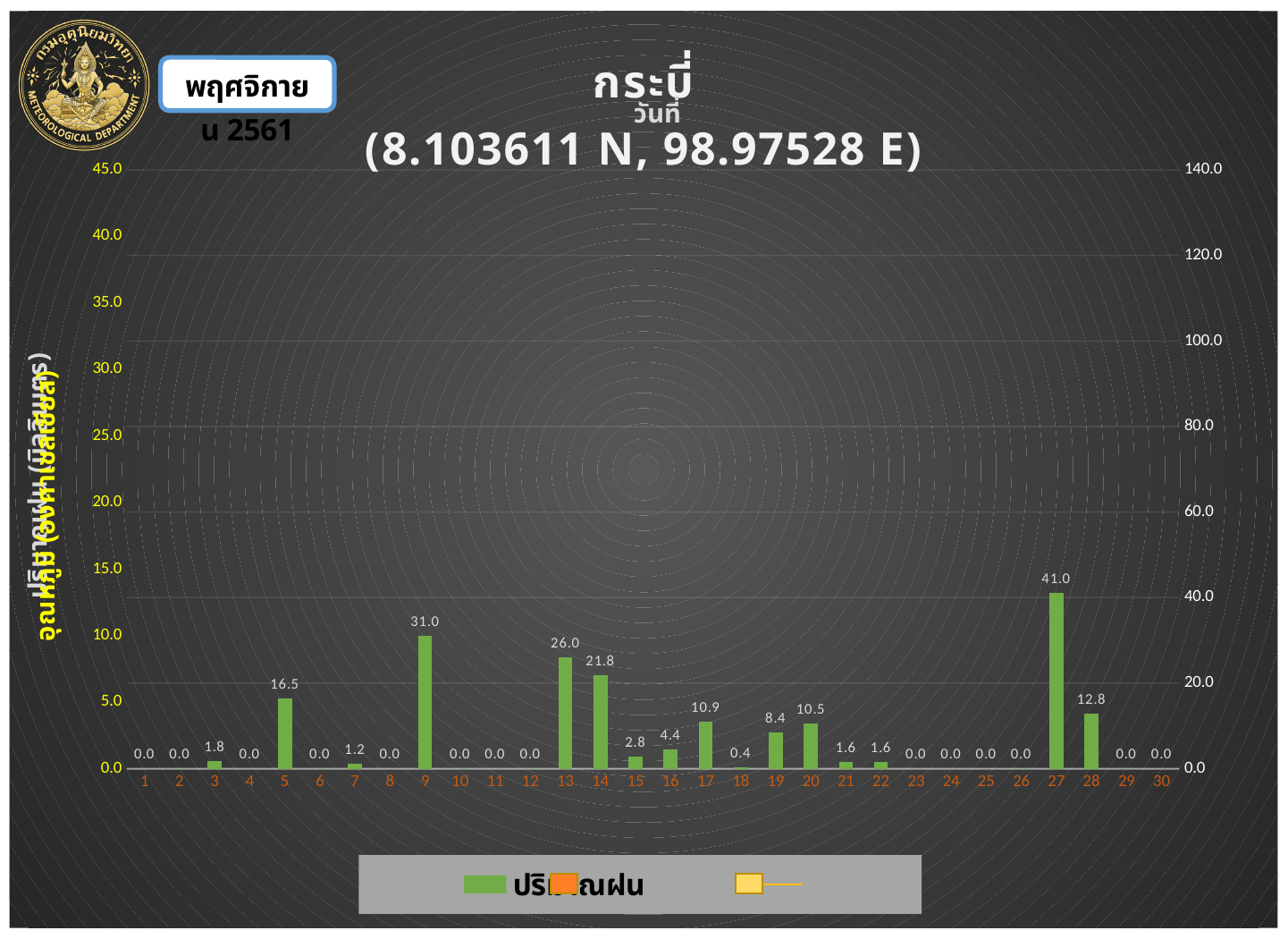
What is the difference between the rainfall values for day 13 and day 14? 4.2 Which has a larger rainfall value, day 5 or day 28? day 5 What is the rainfall value shown for day 14? 21.8 What kind of chart is shown on the slide? bar chart What is the difference between the rainfall values for day 27 and day 9? 10.0 What is the rainfall value shown for day 9? 31.0 What is the rainfall value shown for day 27? 41.0 Which has a larger rainfall value, day 17 or day 20? day 17 What coordinates are given in the chart title? 8.103611 N, 98.97528 E What is the rainfall value shown for day 28? 12.8 Which day has the highest rainfall value? 27 How many days are shown on the x axis? 30